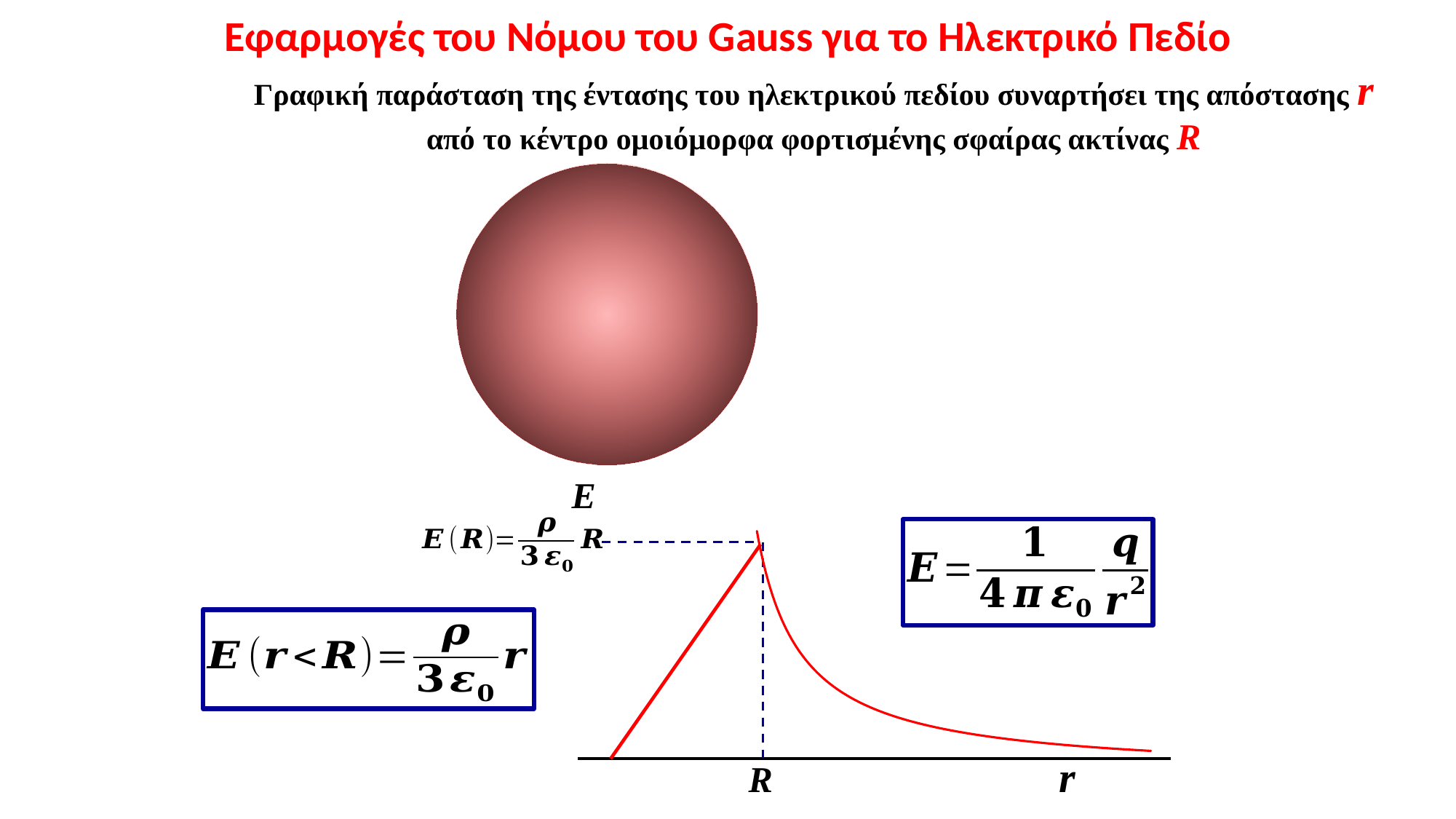
Is E larger at r = R or at the far right end of the r axis? at r = R How does E change as r increases beyond R? falls What colour is the plotted curve on the chart? red At which value of r does the curve reach its maximum? R What kind of chart is shown at the bottom of the slide? line chart How many curves (series) are plotted on the E versus r chart? 1 Is the rise of E for r < R linear or curved? linear How does E change as r increases from 0 up to R? rises What value of E is marked on the vertical axis at r = R? E(R) = ρR/3ε₀ What are the labels of the vertical and horizontal axes of the chart? E (vertical) and r (horizontal)